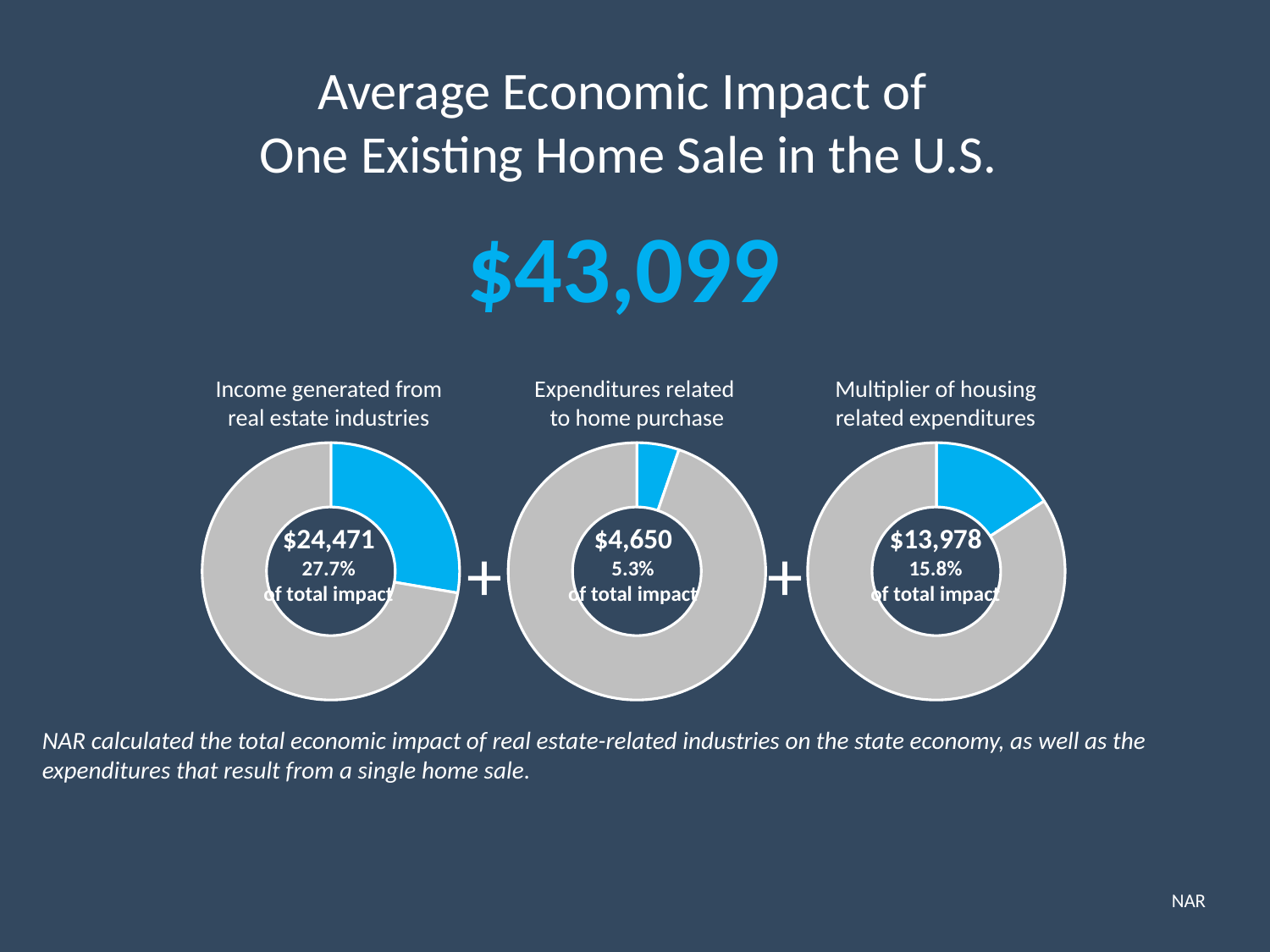
What is the total of the three dollar values shown in the donut charts? $43,099 In the 'Multiplier of housing related expenditures' donut chart, what dollar value is shown? $13,978 What is the difference in dollars between the 'Income generated from real estate industries' value and the 'Multiplier of housing related expenditures' value? $10,493 Across the three donut charts, which component has the largest dollar value? Income generated from real estate industries Across the three donut charts, which component has the smallest dollar value? Expenditures related to home purchase Which is larger: the value in the 'Multiplier of housing related expenditures' chart or the value in the 'Expenditures related to home purchase' chart? Multiplier of housing related expenditures In the 'Expenditures related to home purchase' chart, what share of total impact does the highlighted slice represent? 5.3% In the 'Income generated from real estate industries' donut chart, what dollar value is shown? $24,471 In the 'Income generated from real estate industries' chart, what share of total impact does the highlighted slice represent? 27.7% In the 'Multiplier of housing related expenditures' chart, what share of total impact does the highlighted slice represent? 15.8% In the 'Expenditures related to home purchase' donut chart, what dollar value is shown? $4,650 What kind of chart is used to show each of the three components on the slide? Donut (pie) chart